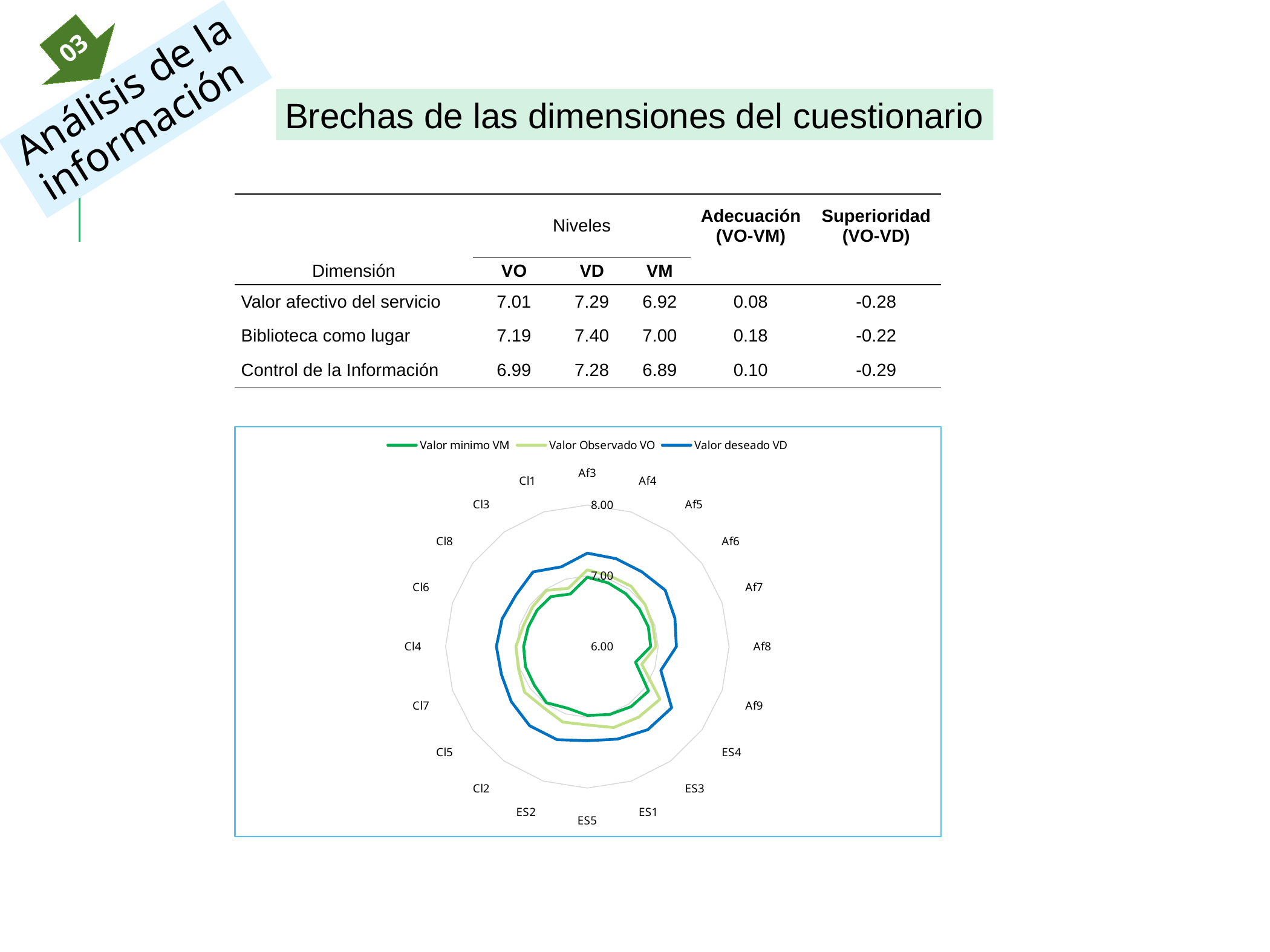
Is the value of Valor minimo VM for Af8 greater or less than 7.00? less Is the value of Valor deseado VD for Cl4 greater or less than 7.00? greater Is the value of Valor deseado VD for ES5 greater or less than 7.00? greater What kind of chart is shown on the slide? radar chart At Af8, which series has the larger value, Valor deseado VD or Valor minimo VM? Valor deseado VD How many categories are plotted around the radar chart? 20 How many series does the chart legend list? 3 At Cl6, which series has the larger value, Valor deseado VD or Valor Observado VO? Valor deseado VD What is the highest axis tick value shown on the radar chart? 8.00 Which series in the chart is drawn in blue? Valor deseado VD